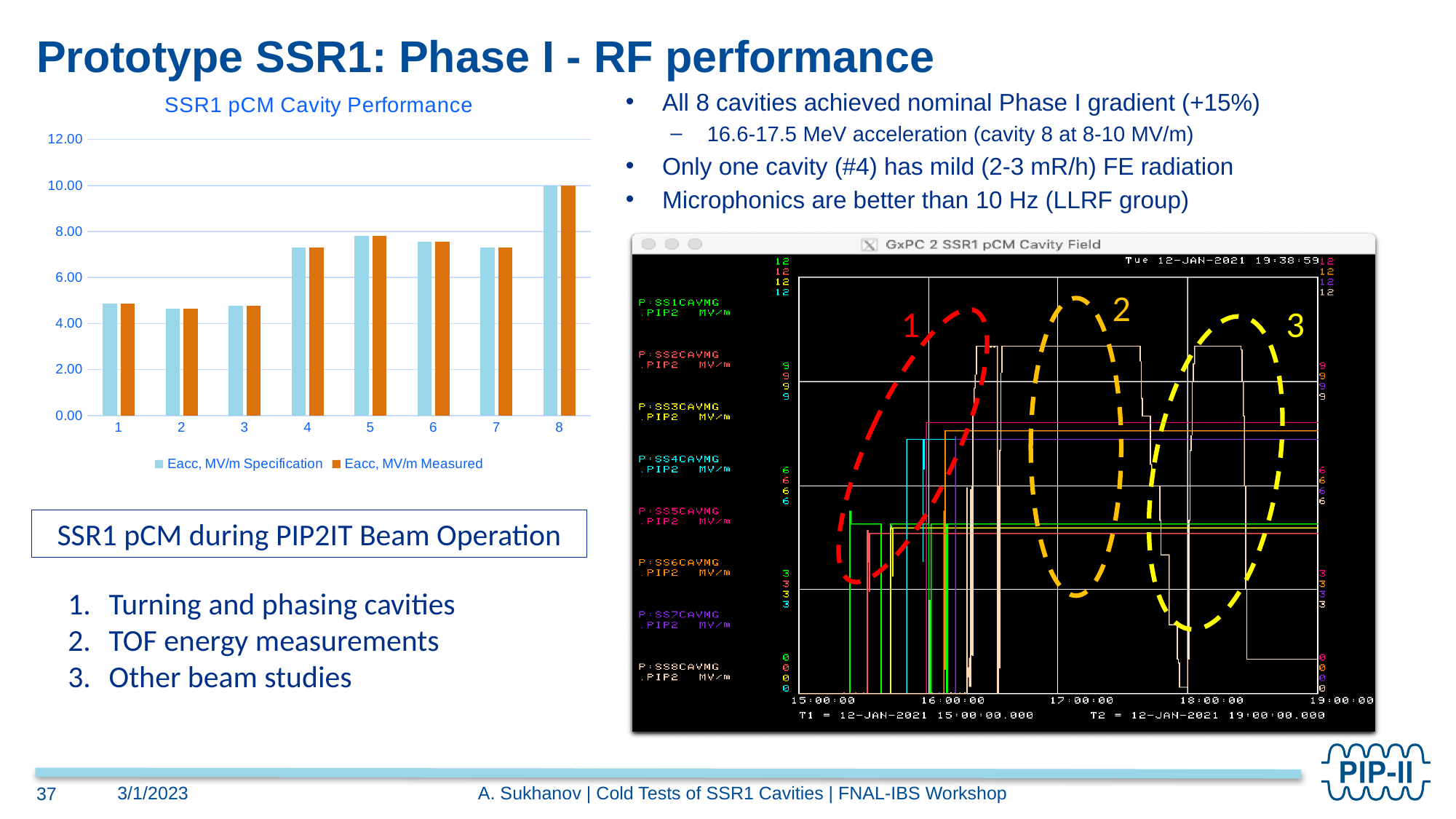
In the 'SSR1 pCM Cavity Performance' chart, is the measured Eacc for cavity 8 greater or less than 8.00? greater What are the two legend entries of the 'SSR1 pCM Cavity Performance' chart? Eacc, MV/m Specification; Eacc, MV/m Measured How many cavities (categories) are shown on the x axis of the 'SSR1 pCM Cavity Performance' chart? 8 How many series does the legend of the 'SSR1 pCM Cavity Performance' chart list? 2 In the 'SSR1 pCM Cavity Performance' chart, is the measured Eacc for cavity 2 greater or less than 6.00? less In the 'SSR1 pCM Cavity Performance' chart, which has the larger measured Eacc: cavity 5 or cavity 2? cavity 5 In the 'SSR1 pCM Cavity Performance' chart, is the Eacc specification for cavity 1 greater or less than 6.00? less What kind of chart is the 'SSR1 pCM Cavity Performance' chart? bar chart In the 'SSR1 pCM Cavity Performance' chart, which has the larger measured Eacc: cavity 8 or cavity 4? cavity 8 In the 'SSR1 pCM Cavity Performance' chart, which cavity has the highest measured Eacc? 8 What is the title of the bar chart on the left of the slide? SSR1 pCM Cavity Performance